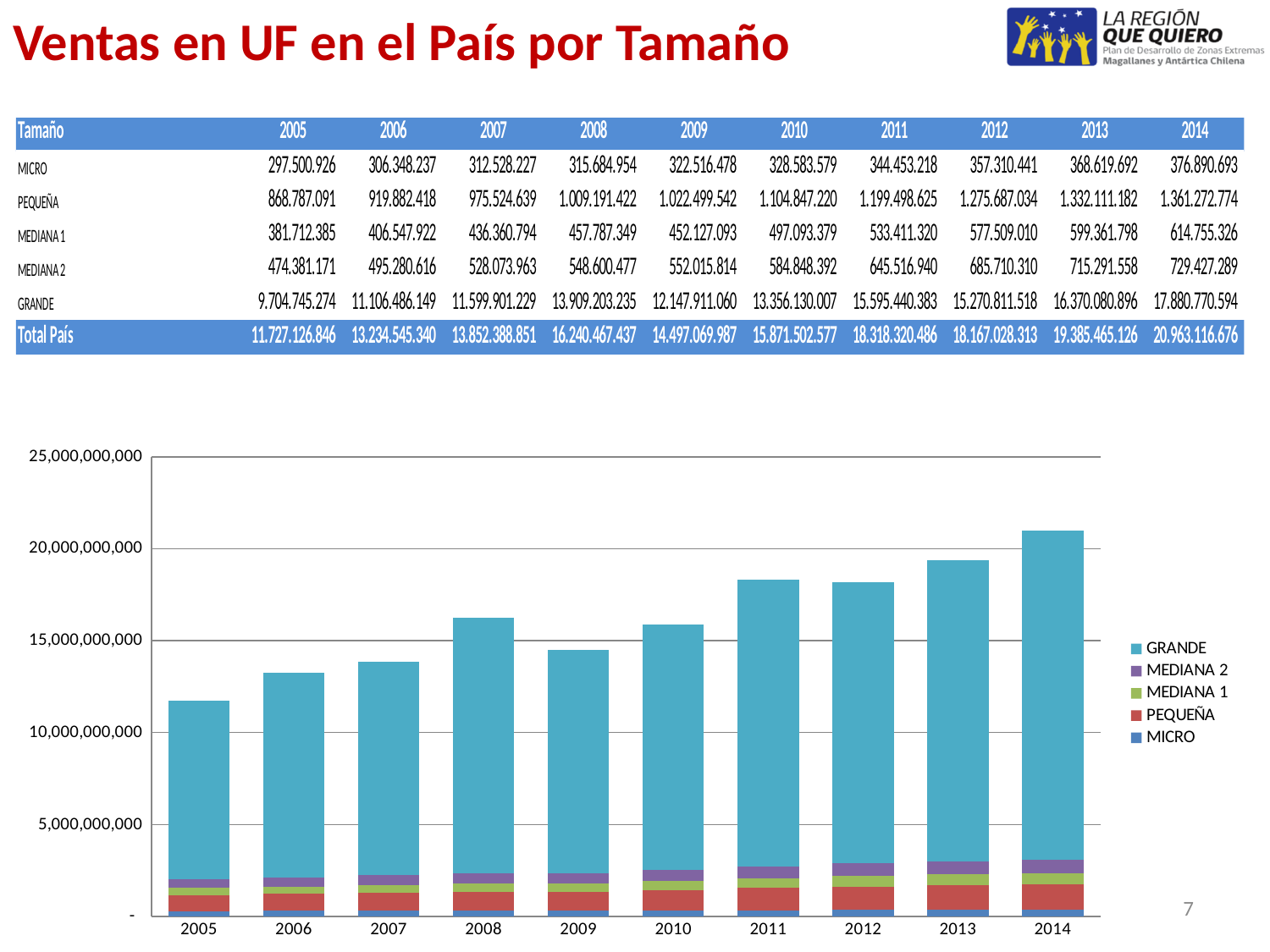
According to the table, what is the Total País value for 2010? 15.871.502.577 Which year has the taller total bar, 2008 or 2009? 2008 Which series is listed first (at the top) in the chart legend? GRANDE Is the total bar for 2009 greater or less than 15,000,000,000? less According to the table, what is the GRANDE value for 2014? 17.880.770.594 What kind of chart is shown on the slide? bar chart How many years are shown along the x axis of the chart? 10 Which year has the lowest total bar in the chart? 2005 Which year has the highest total bar in the chart? 2014 Do the total bars generally rise or fall from 2005 to 2014? rise Is the total bar for 2014 greater or less than 20,000,000,000? greater How many series does the chart legend list? 5